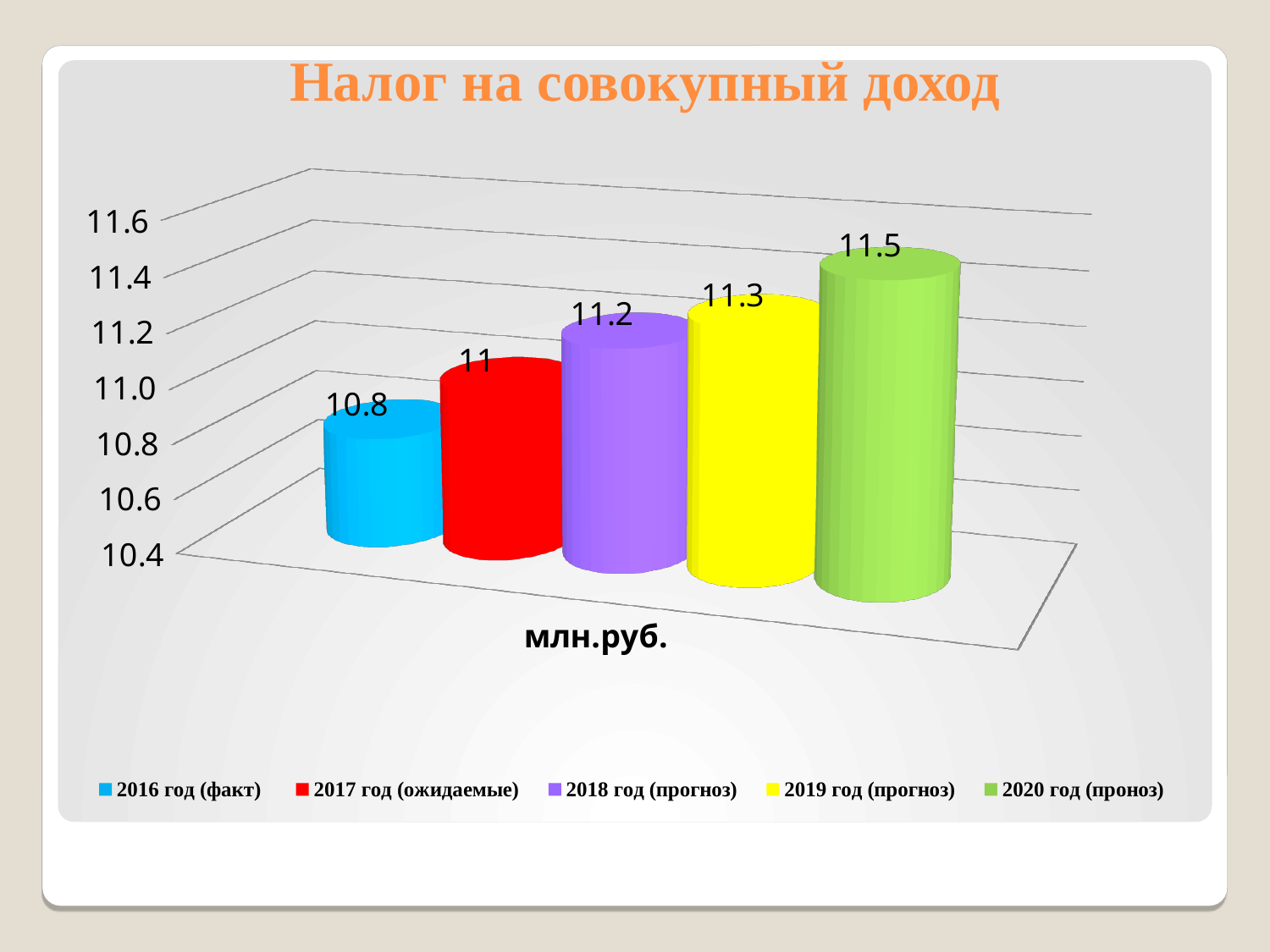
Which year has the lowest value? 2016 год (факт) How many bars are shown in the chart? 5 Which year has the highest value? 2020 год (проноз) What kind of chart is shown on the slide? bar chart How many series does the legend list? 5 What is the difference between the values for 2020 год (проноз) and 2016 год (факт)? 0.7 What is the difference between the values for 2019 год (прогноз) and 2017 год (ожидаемые)? 0.3 What is the value for 2018 год (прогноз)? 11.2 What is the value for 2020 год (проноз)? 11.5 What is the value for 2016 год (факт)? 10.8 Which is larger, the value for 2017 год (ожидаемые) or 2018 год (прогноз)? 2018 год (прогноз) Do the values rise or fall from 2016 to 2020? rise